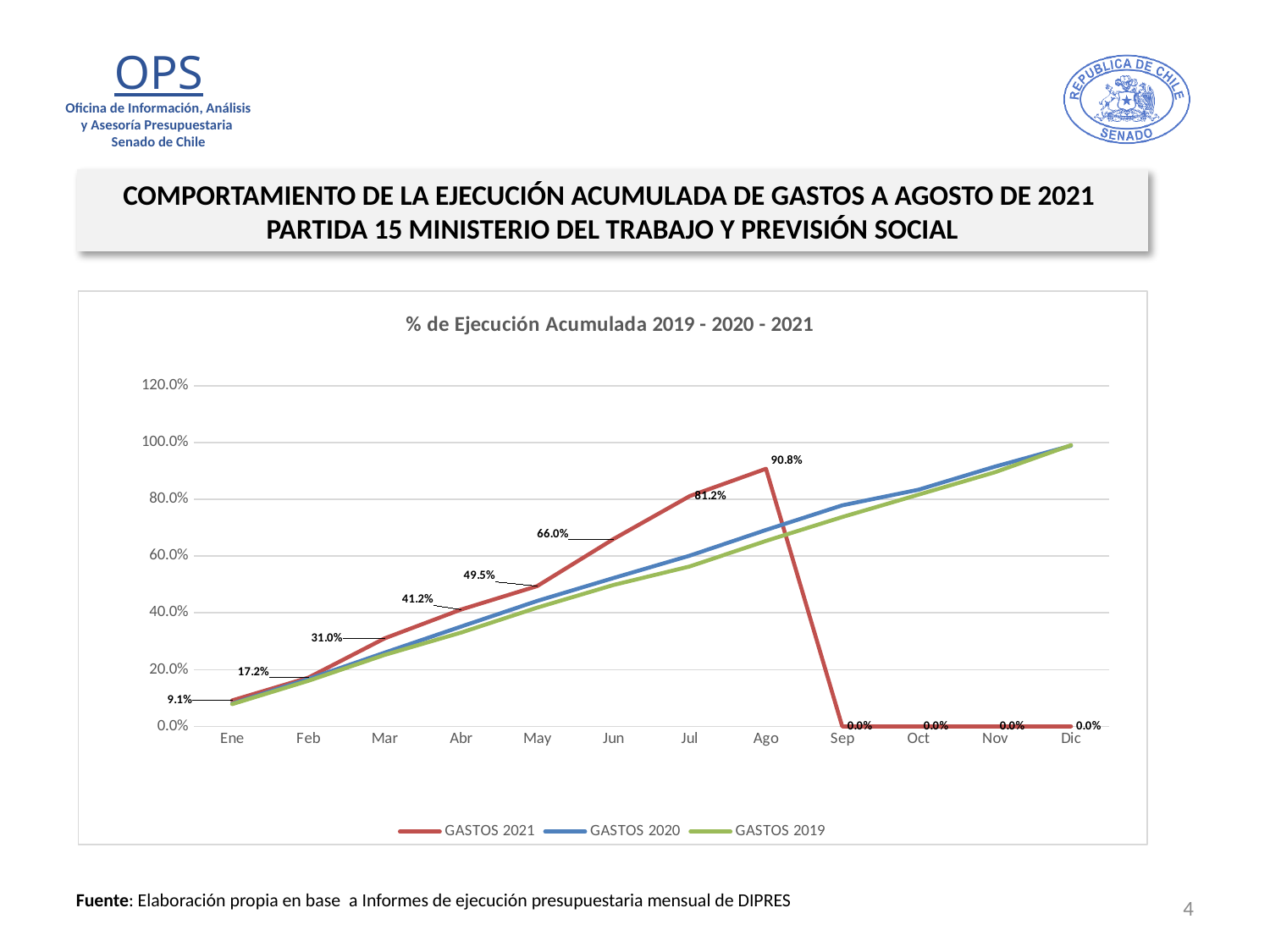
In which month does GASTOS 2021 reach its highest value? Ago What is the value for GASTOS 2021 in Ene? 9.1% What kind of chart is shown on the slide? Line chart How many series does the legend list? 3 What is the value for GASTOS 2021 in May? 49.5% Which is larger for GASTOS 2021: the value in Mar or the value in Abr? Abr Is the value for GASTOS 2020 in Dic greater or less than 80.0%? greater What is the difference between the GASTOS 2021 values for Ago and Jul? 9.6% What is the value for GASTOS 2021 in Ago? 90.8% Does the GASTOS 2021 line rise or fall from Ene to Ago? Rise How many months are shown on the x axis? 12 What is the value for GASTOS 2021 in Jul? 81.2%